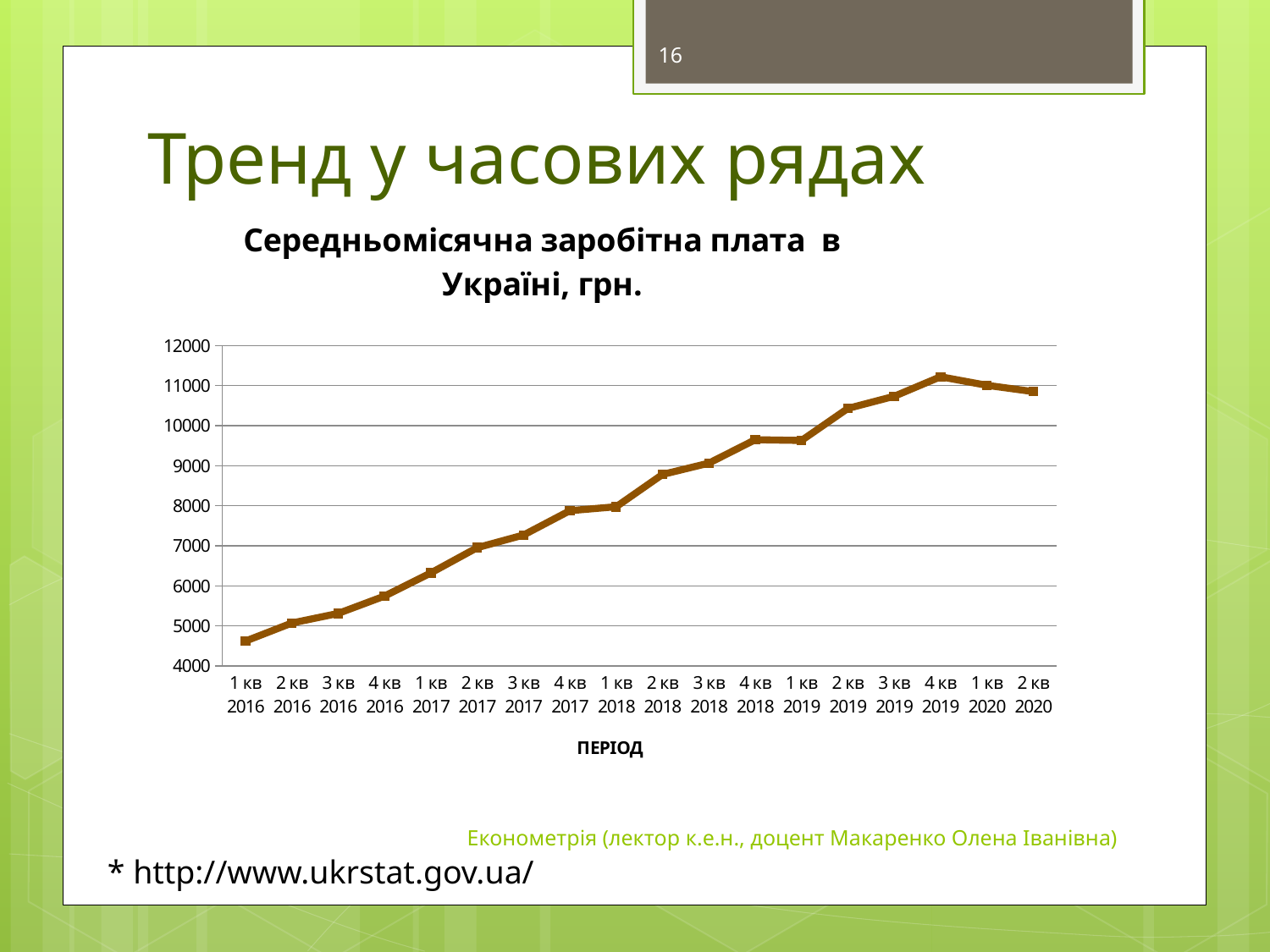
Is the value for 4 кв 2016 greater or less than 6000? less Is the value for 2 кв 2019 greater or less than 10000? greater What kind of chart is shown on the slide? line chart Is the value for 4 кв 2019 greater or less than 11000? greater Which period has the highest average monthly wage? 4 кв 2019 What is the title of the chart? Середньомісячна заробітна плата в Україні, грн. What is the label of the x axis? ПЕРІОД Which period has the lowest average monthly wage? 1 кв 2016 Do the values generally rise or fall from 1 кв 2016 to 4 кв 2019? rise How many periods (points) are plotted along the x axis? 18 Which is larger, the value for 4 кв 2019 or the value for 2 кв 2020? 4 кв 2019